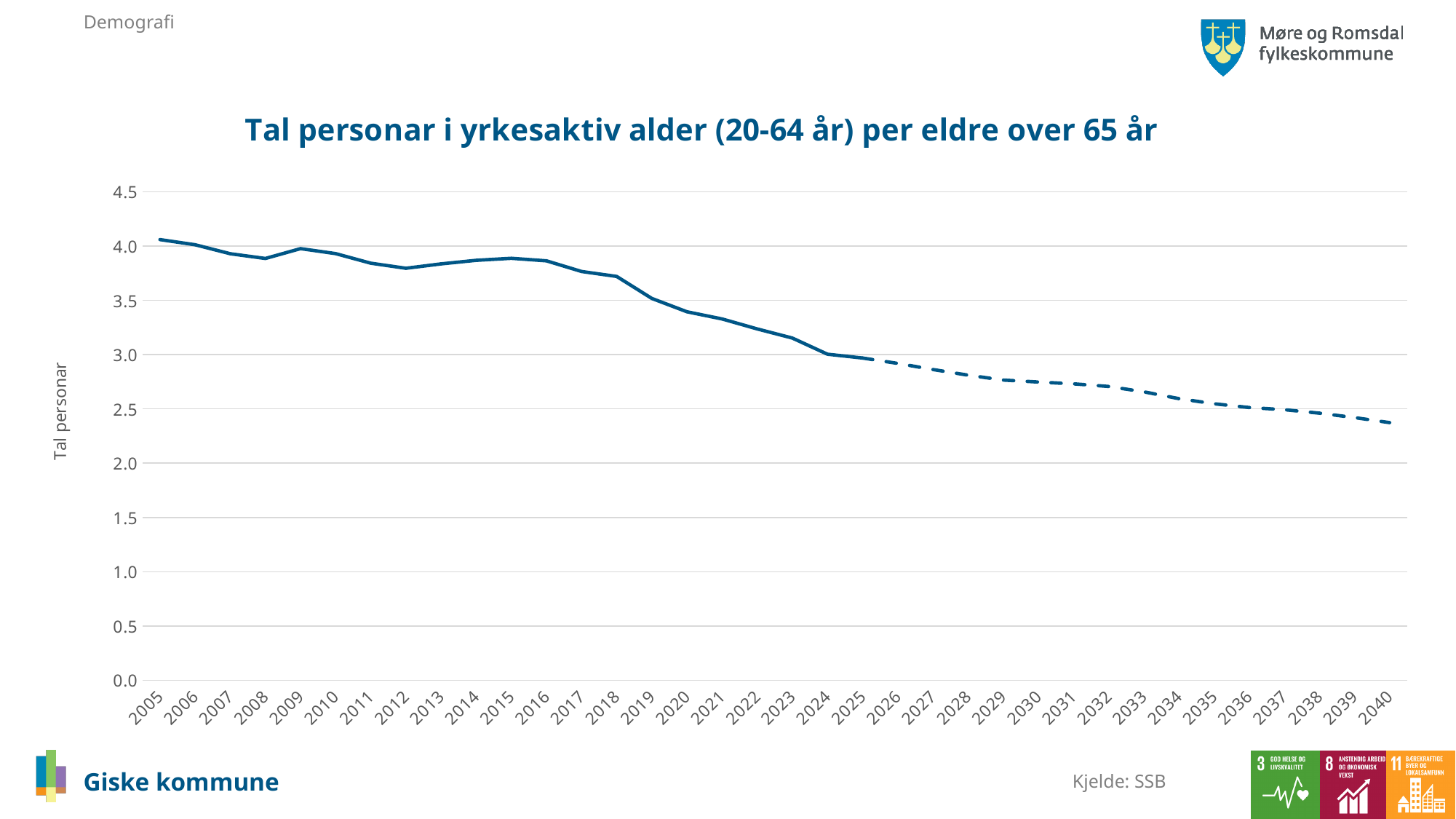
Which year has the larger value, 2010 or 2025? 2010 What is the title of the chart? Tal personar i yrkesaktiv alder (20-64 år) per eldre over 65 år How many years are shown along the x axis of the chart? 36 What is the label on the y axis of the chart? Tal personar Which year has the lowest value on the chart? 2040 What kind of chart is shown on the slide? line chart Is the value for 2020 greater or less than 3.5? less Which year has the highest value on the chart? 2005 Is the value for 2015 greater or less than 3.5? greater Do the values generally rise or fall from 2005 to 2040? fall Is the value for 2030 greater or less than 3.0? less